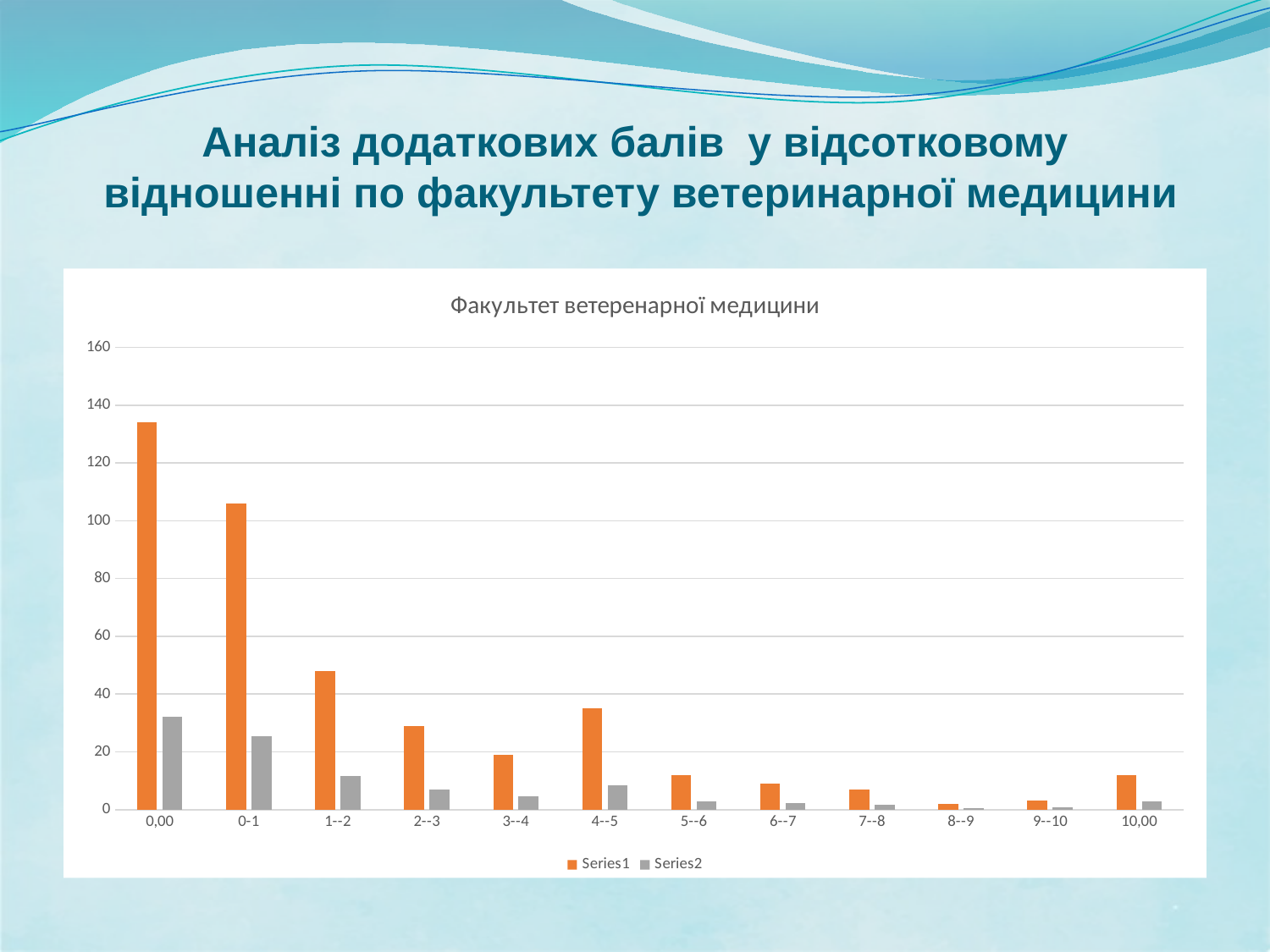
How many categories are shown along the x axis? 12 Is the Series1 value for 4--5 greater or less than 40? less What kind of chart is shown on the slide? bar chart Is the Series1 value for 0,00 greater or less than 120? greater Is the Series1 value for 0-1 greater or less than 100? greater Which is larger for Series1: the value for 1--2 or the value for 4--5? 1--2 Which category has the highest value for Series2? 0,00 What is the title shown inside the chart area? Факультет ветеренарної медицини Which category has the highest value for Series1? 0,00 Do the Series1 values rise or fall from 0,00 to 2--3? fall How many series does the legend list? 2